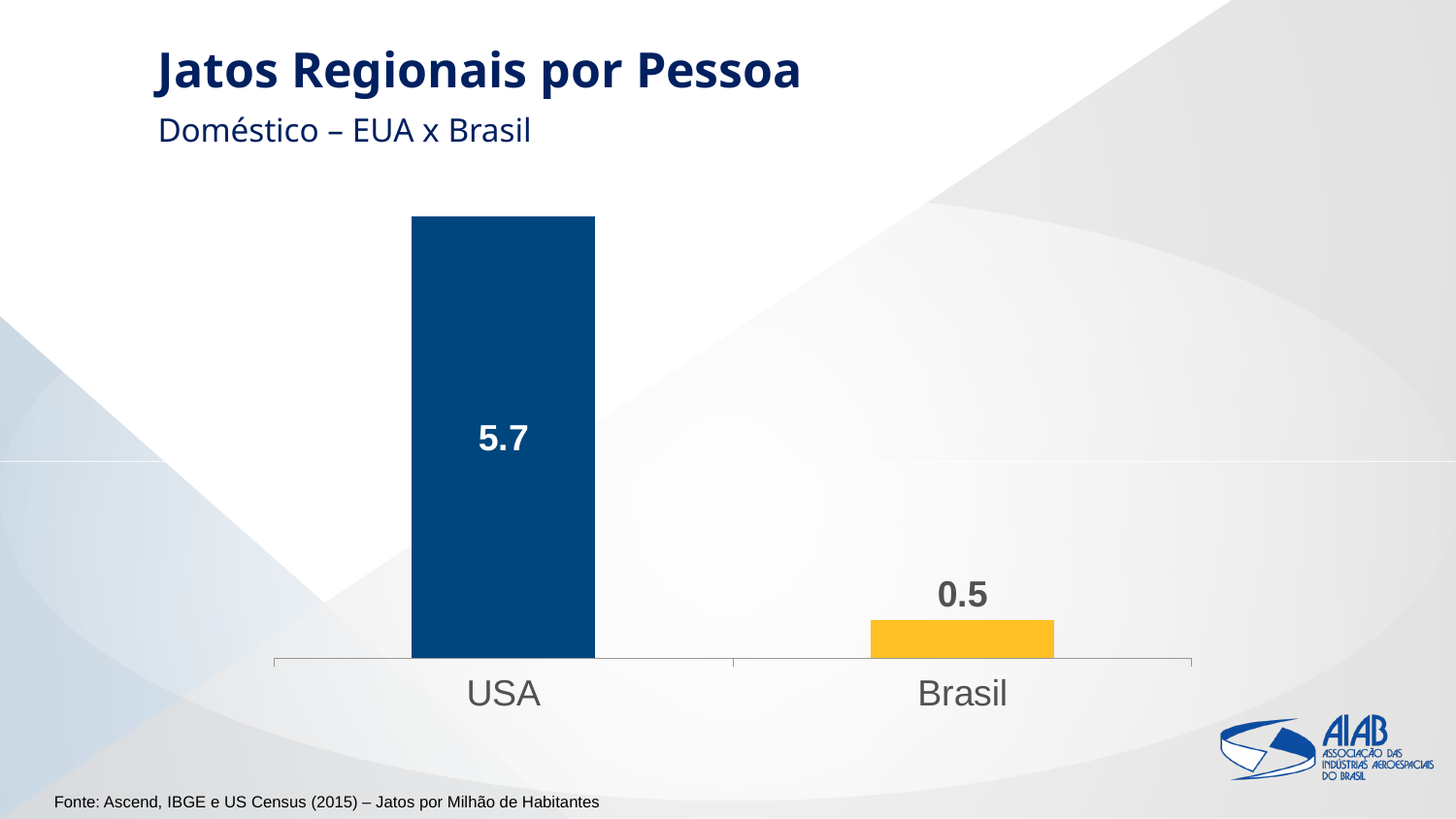
What is the difference between the values for USA and Brasil? 5.2 What kind of chart is shown on the slide? Bar chart Which category has the lowest value? Brasil What is the value for Brasil? 0.5 How many categories are shown in the chart? 2 What is the title of the slide containing the chart? Jatos Regionais por Pessoa Which category has the highest value? USA Which is larger, the value for USA or the value for Brasil? USA What is the value for USA? 5.7 What colour is the bar for Brasil? Yellow